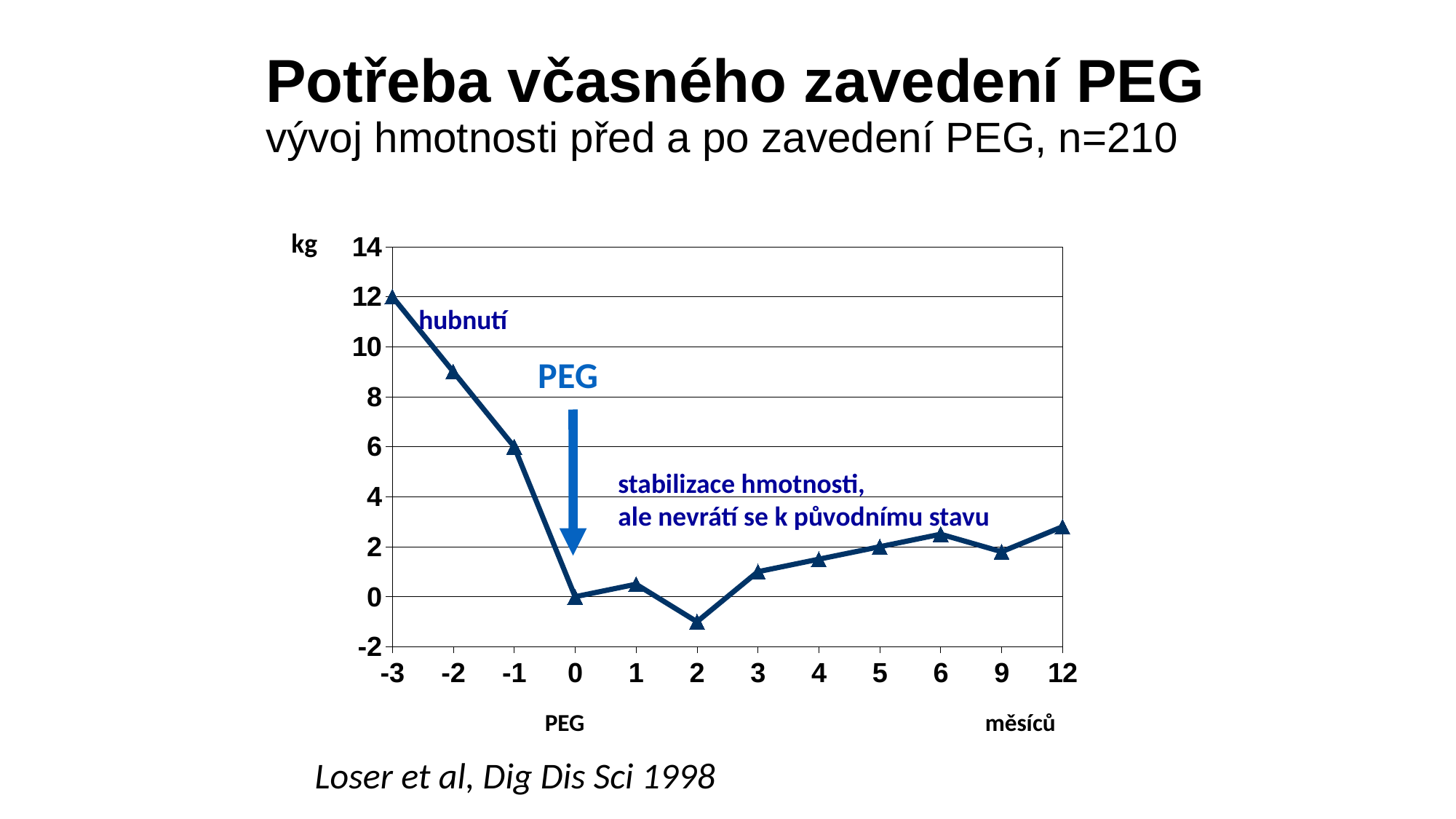
At which month is the value highest? -3 What is the value at month -3? 12 At which month is the value lowest? 2 Is the value at month 2 greater or less than 0? less How many data points are plotted on the line? 12 What kind of chart is shown on the slide? line chart What is the value at month 0 (PEG)? 0 What is the difference between the values at month -3 and month -1? 6 Is the value at month -2 greater or less than 8? greater What is the value at month -1? 6 Do the values rise or fall from month -3 to month 0? fall What is the value at month 5? 2